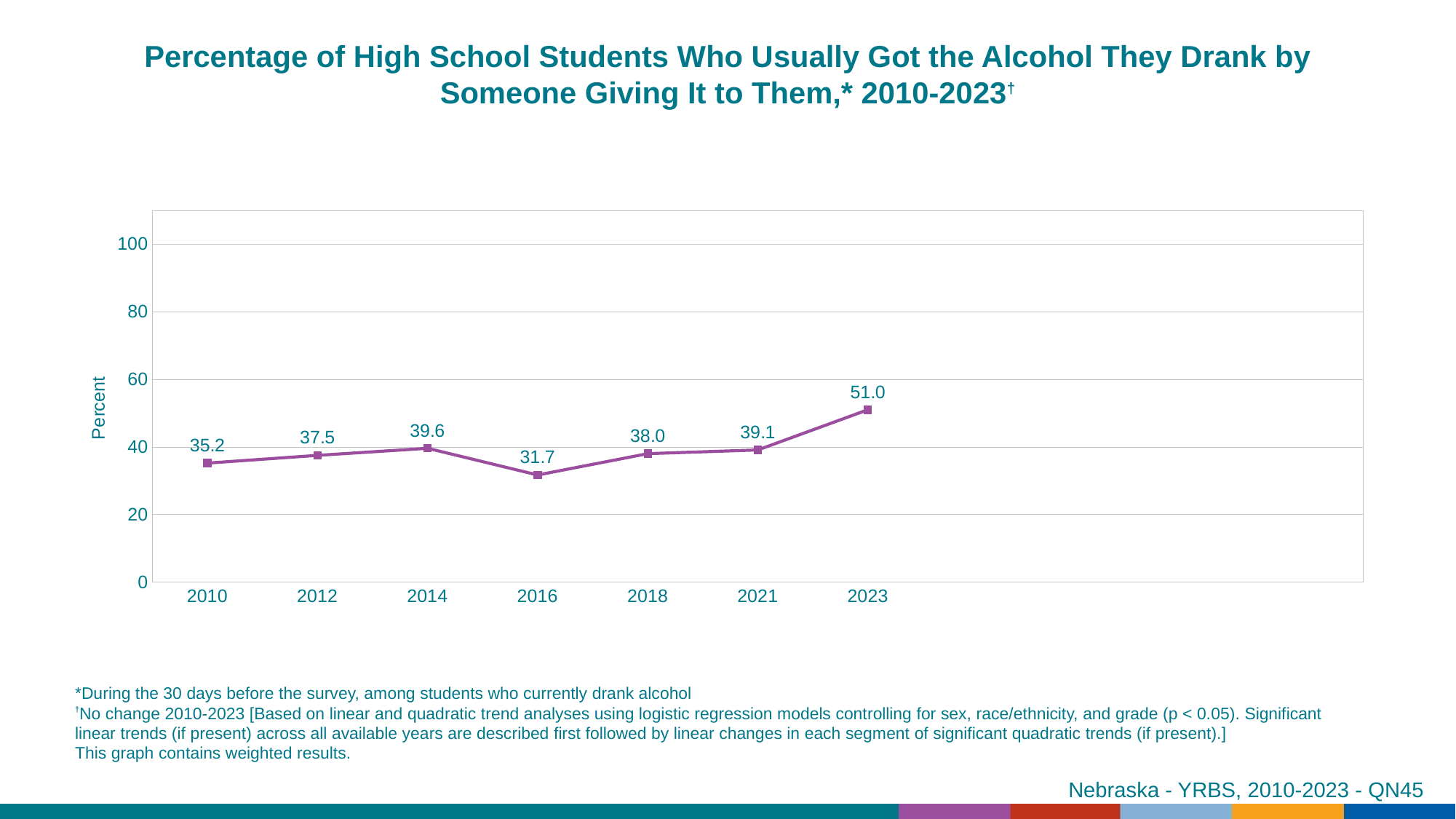
Which year has the lowest value? 2016 Is the value for 2023 greater or less than 40? greater What is the difference between the values for 2014 and 2016? 7.9 What is the value for 2016? 31.7 How many years are plotted on the chart? 7 What is the value for 2023? 51.0 What is the value for 2010? 35.2 What is the difference between the values for 2023 and 2021? 11.9 Which year has the highest value? 2023 What kind of chart is shown on the slide? line chart Which is larger, the value for 2012 or the value for 2018? 2018 What is the label on the y axis? Percent